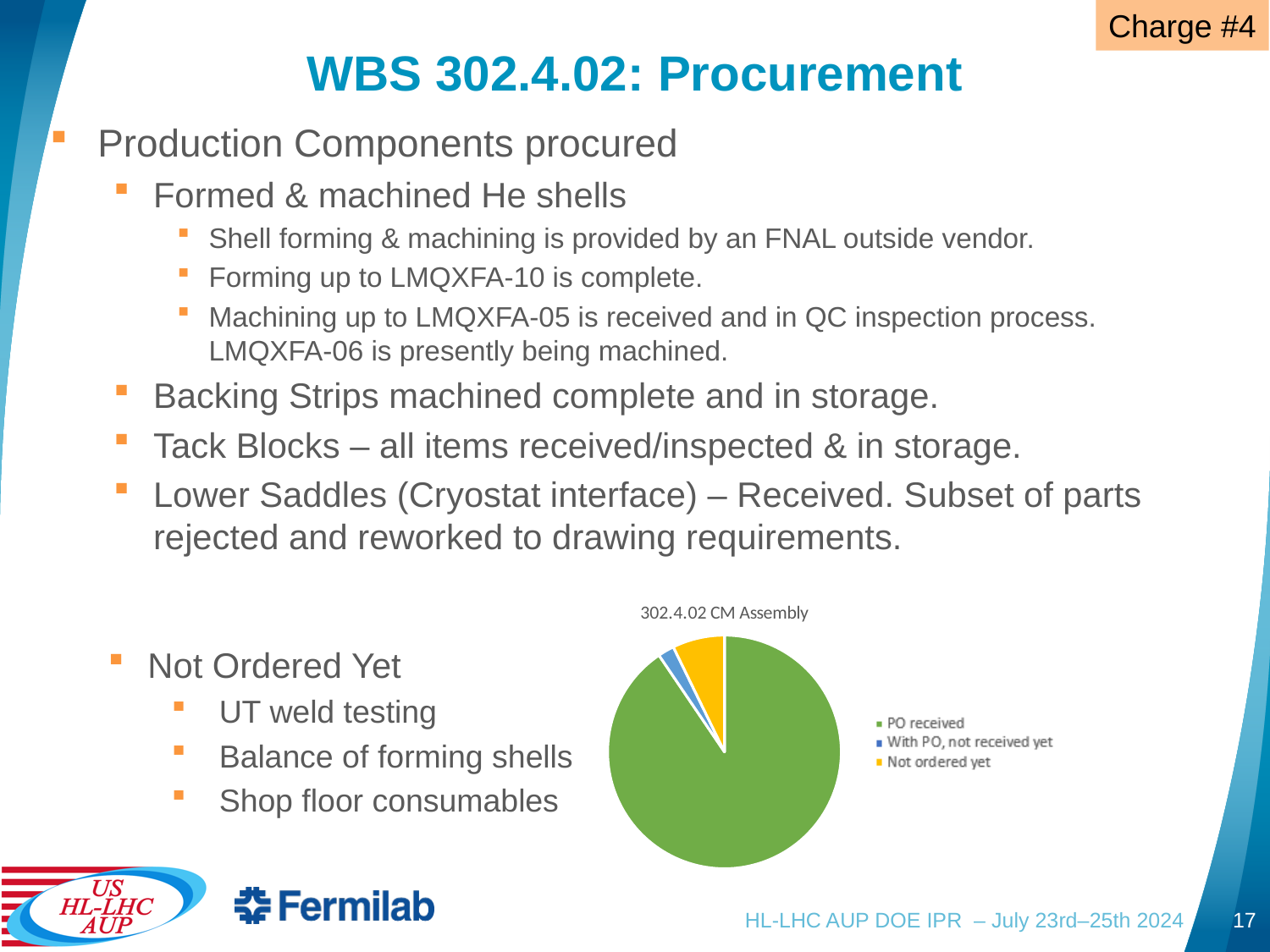
What kind of chart is shown on the slide? pie chart What is the title of the pie chart? 302.4.02 CM Assembly Which category takes up the smallest share of the pie chart? With PO, not received yet Which is larger in the pie chart: the slice for 'Not ordered yet' or the slice for 'With PO, not received yet'? Not ordered yet Does the 'PO received' slice make up more or less than half of the pie chart? more Which is larger in the pie chart: the slice for 'PO received' or the slice for 'Not ordered yet'? PO received How many entries does the legend of the pie chart list? 3 How many slices does the pie chart have? 3 Which category takes up the largest share of the pie chart? PO received What colour is the 'PO received' slice in the pie chart? green